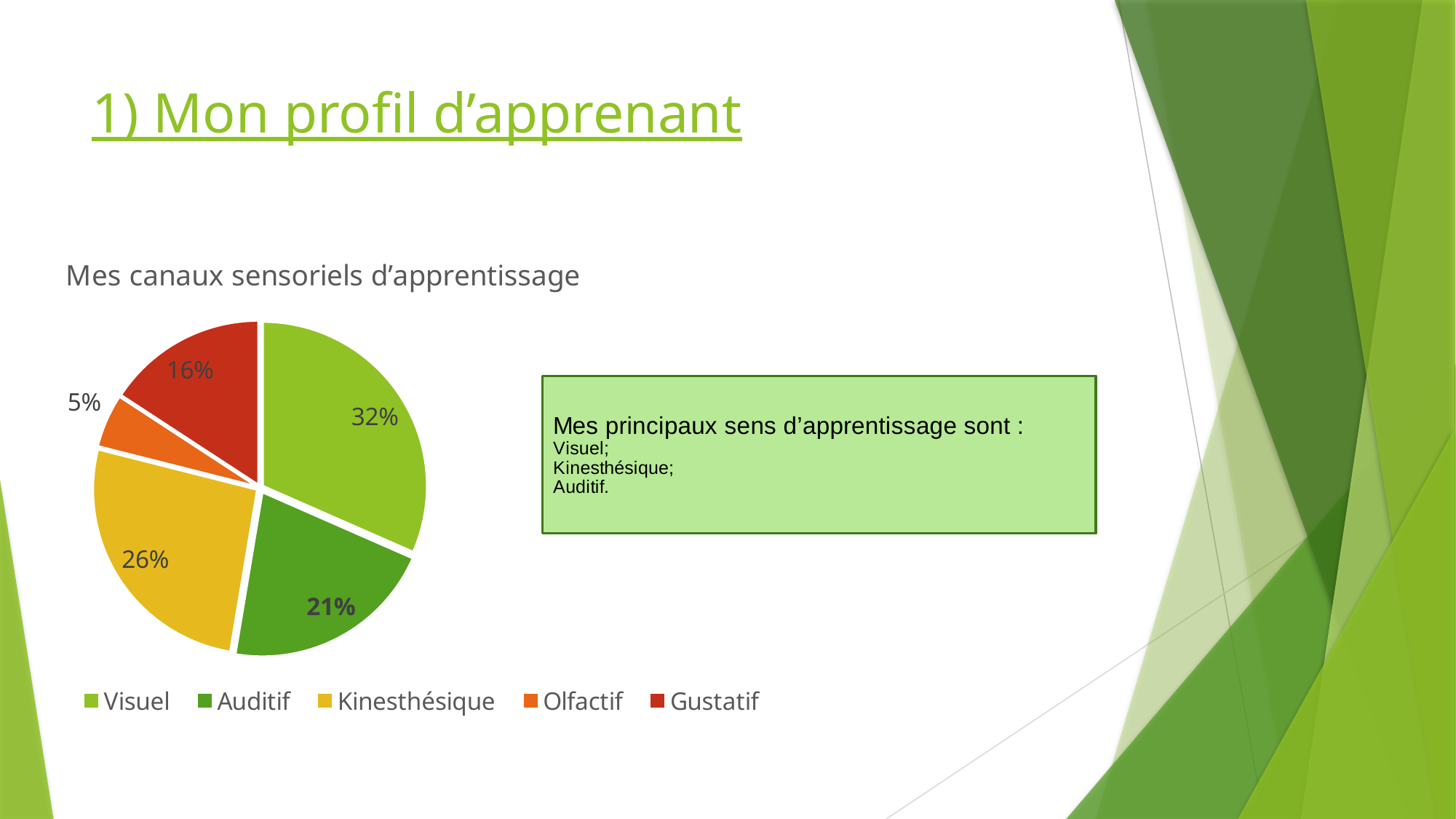
What share of the pie does Kinesthésique have? 26% Which category has the smallest slice of the pie? Olfactif What is the difference between the Visuel and Auditif shares? 11% What share of the pie does Gustatif have? 16% Which is larger, the Kinesthésique share or the Gustatif share? Kinesthésique What share of the pie does Olfactif have? 5% How many categories does the legend list? 5 What kind of chart is shown on the slide? pie chart What is the chart's title? Mes canaux sensoriels d'apprentissage Which category has the largest slice of the pie? Visuel